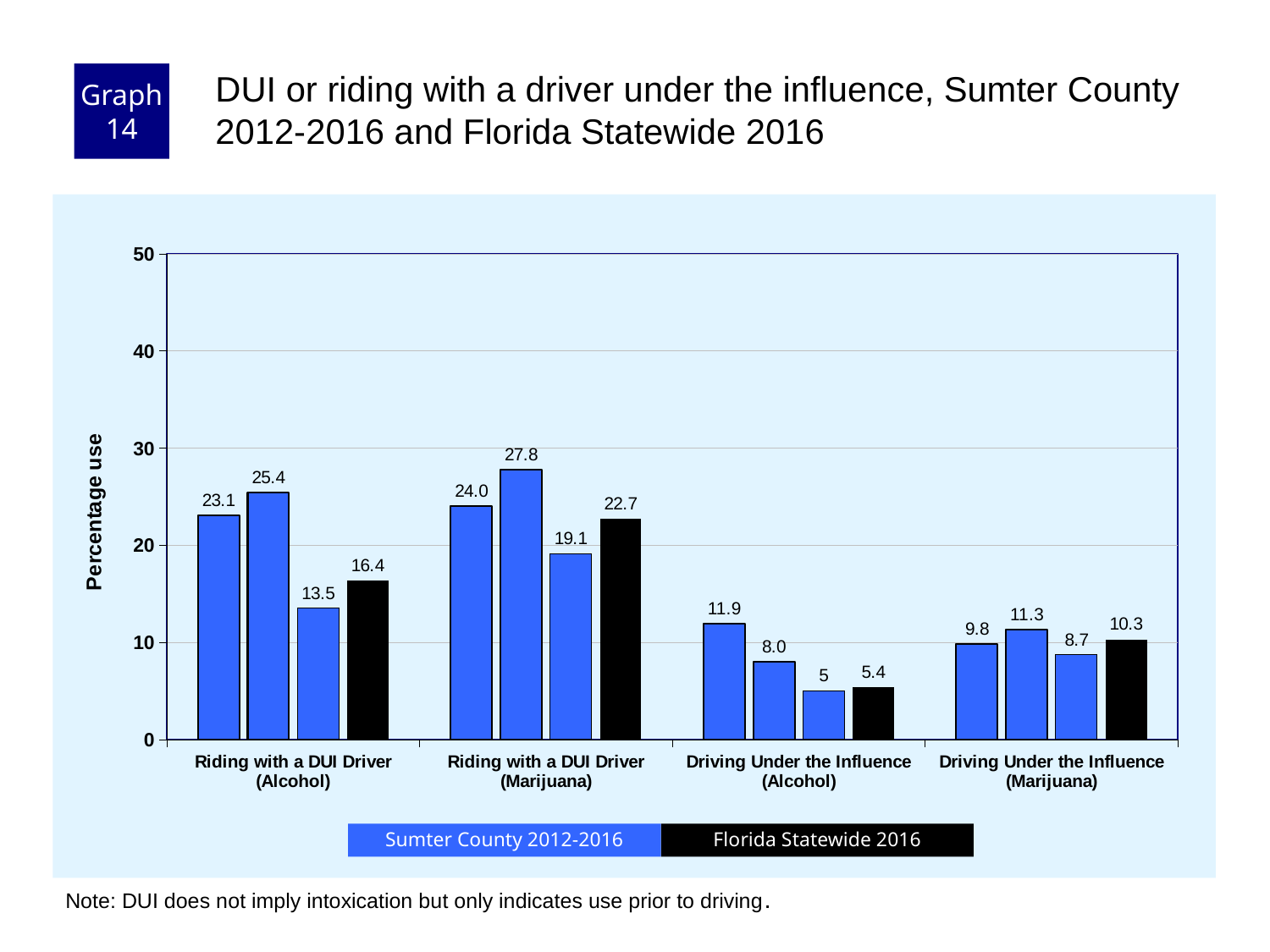
What is the value of the lowest bar in the Driving Under the Influence (Alcohol) group? 5 What is the Florida Statewide 2016 value for Riding with a DUI Driver (Marijuana)? 22.7 What is the label of the y axis? Percentage use What is the Florida Statewide 2016 value for Riding with a DUI Driver (Alcohol)? 16.4 Is the Florida Statewide 2016 value for Riding with a DUI Driver (Marijuana) greater or less than 20? greater How many entries does the legend list? 2 Which is larger: the Florida Statewide 2016 value for Driving Under the Influence (Marijuana) or the Florida Statewide 2016 value for Driving Under the Influence (Alcohol)? Driving Under the Influence (Marijuana) What is the difference between the Florida Statewide 2016 value for Riding with a DUI Driver (Marijuana) and the Florida Statewide 2016 value for Riding with a DUI Driver (Alcohol)? 6.3 What is the value of the highest bar in the Riding with a DUI Driver (Marijuana) group? 27.8 How many categories are shown along the x axis? 4 What kind of chart is shown on the slide? bar chart What is the Florida Statewide 2016 value for Driving Under the Influence (Alcohol)? 5.4